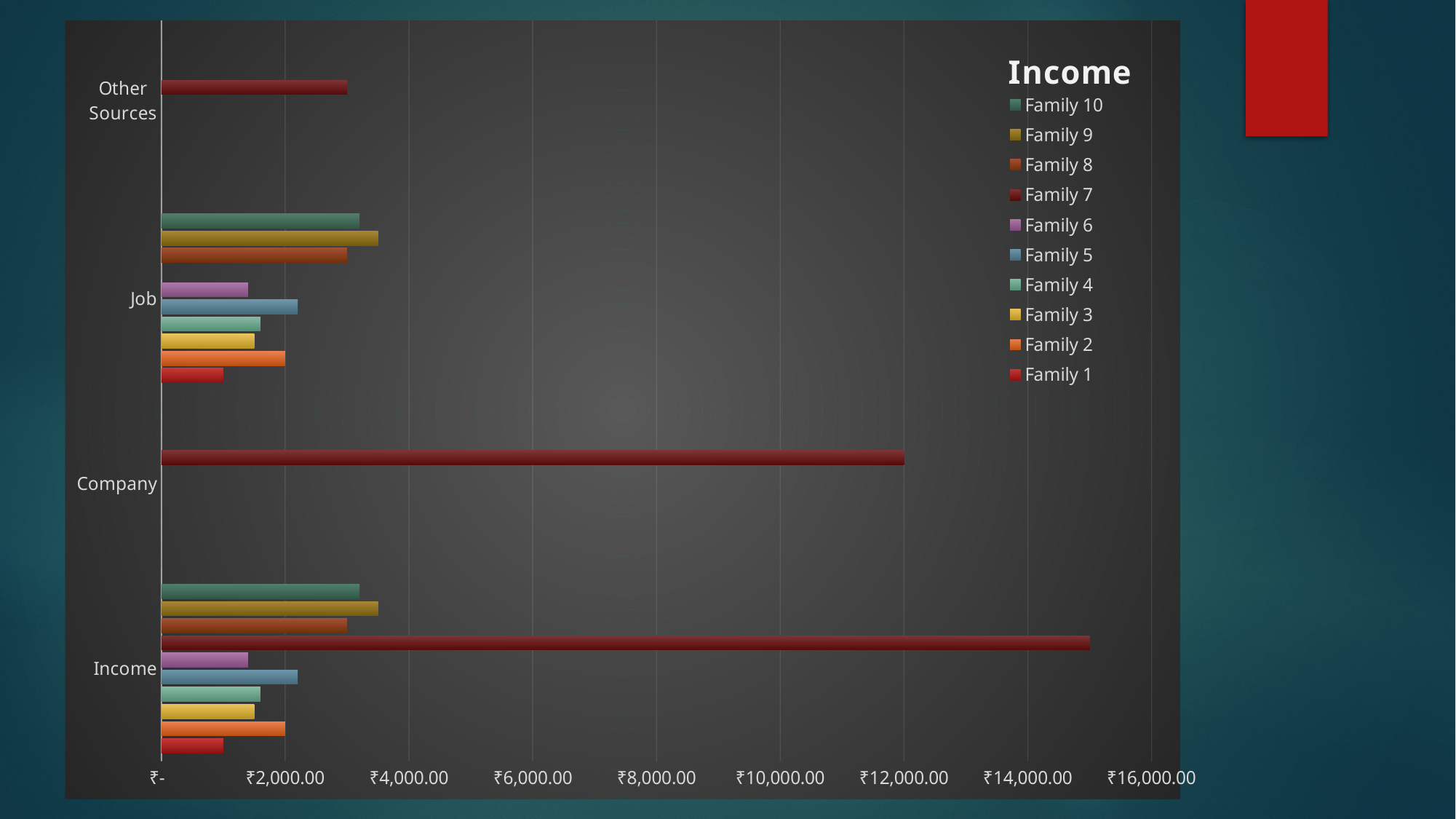
Is the value for Family 1 in the Job category greater or less than ₹2,000.00? less How many categories are shown on the vertical axis? 4 Is the value for Family 7 in the Income category greater or less than ₹14,000.00? greater How many series does the legend list? 10 What is the title of the chart? Income In the Job category, which is larger: the value for Family 9 or the value for Family 6? Family 9 Which family has the shortest bar in the Job category? Family 1 Is the value for Family 7 in the Company category greater or less than ₹10,000.00? greater What kind of chart is shown on the slide? bar chart Which family has the longest bar in the Income category? Family 7 Which family is the only one with a bar in the Company category? Family 7